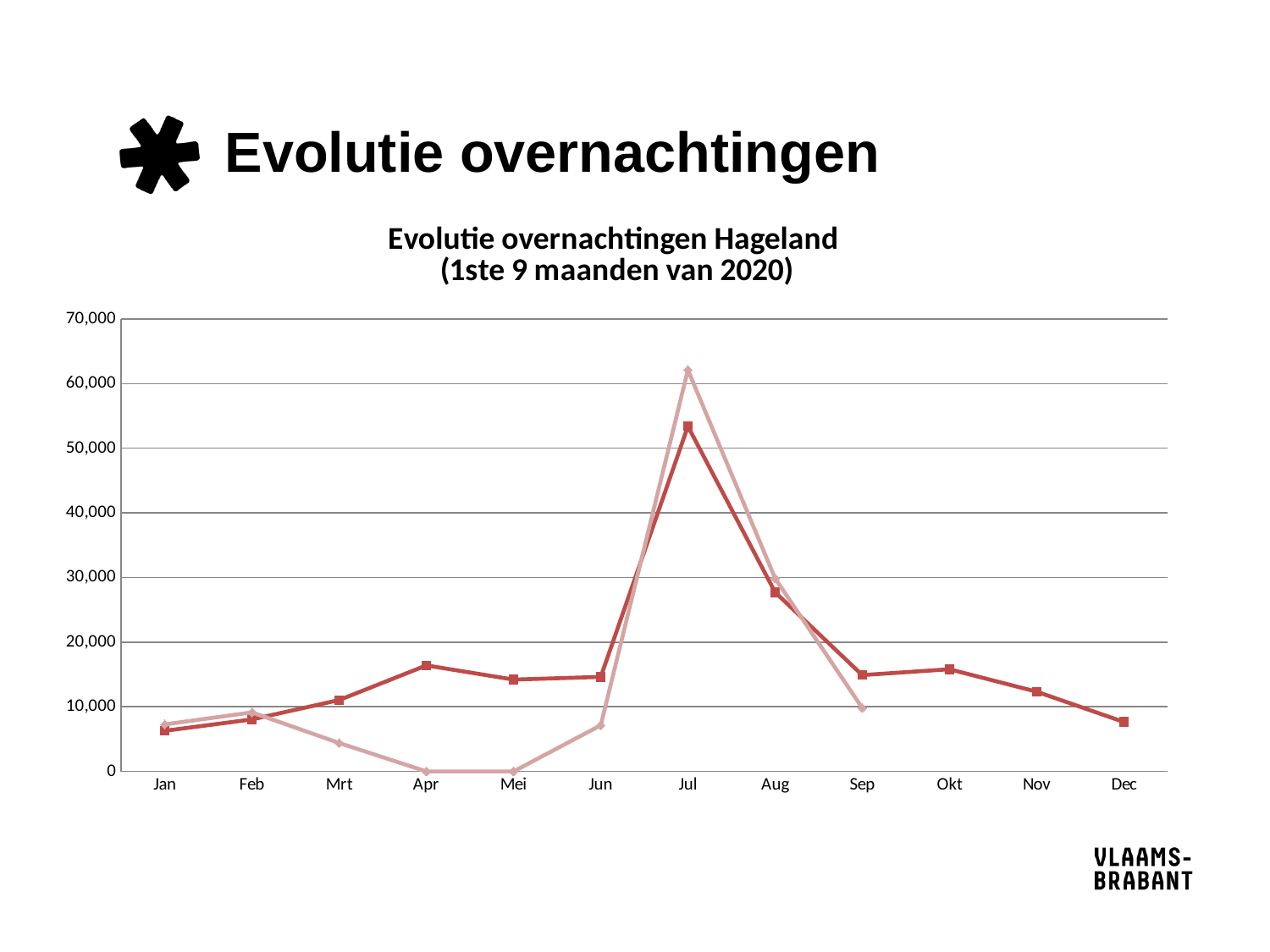
Is the value of the darker red line with square markers for Dec greater or less than 10,000? less How many months are shown on the x axis of the chart? 12 What value does the lighter pink line with diamond markers show for Apr? 0 In Jul, which line is higher: the darker red line with square markers or the lighter pink line with diamond markers? the lighter pink line with diamond markers Is the value of the darker red line with square markers for Aug greater or less than 30,000? less In which month does the lighter pink line with diamond markers reach its highest value? Jul What kind of chart is shown on the slide? line chart In Apr, which line is higher: the darker red line with square markers or the lighter pink line with diamond markers? the darker red line with square markers Is the value of the darker red line with square markers for Jul greater or less than 50,000? greater In which month does the darker red line with square markers reach its highest value? Jul From Jul to Sep, does the darker red line with square markers rise or fall? fall What is the title of the chart? Evolutie overnachtingen Hageland (1ste 9 maanden van 2020)